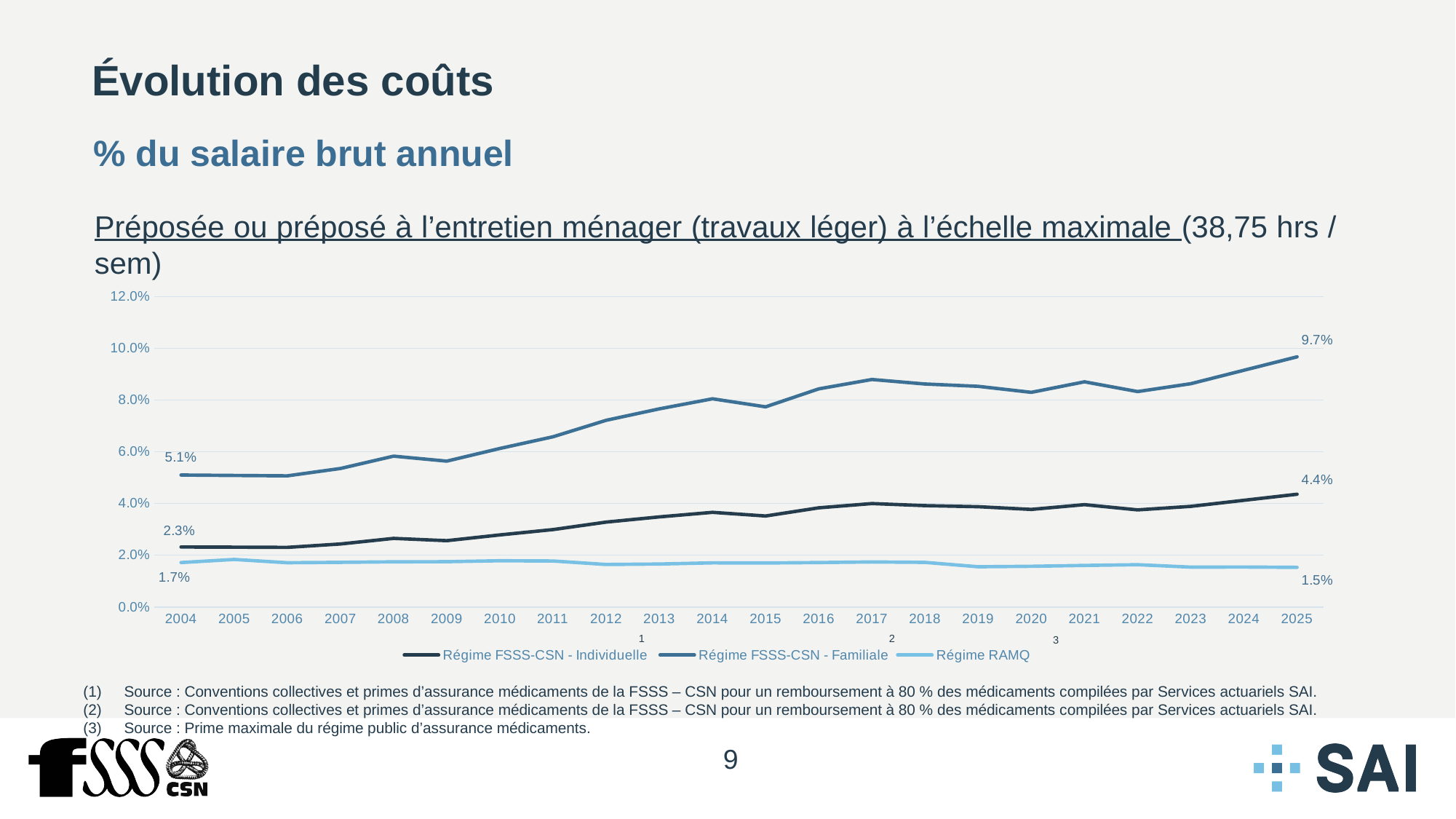
What is the value for Régime RAMQ in 2025? 1.5% What is the value for Régime FSSS-CSN - Individuelle in 2004? 2.3% What is the value for Régime FSSS-CSN - Familiale in 2004? 5.1% What is the value for Régime FSSS-CSN - Familiale in 2025? 9.7% Does the Régime FSSS-CSN - Individuelle series generally rise or fall from 2004 to 2025? rise What kind of chart is shown on the slide? line chart How many series does the legend list? 3 By how much did the Régime FSSS-CSN - Familiale value change from 2004 to 2025? 4.6% Is the value for Régime FSSS-CSN - Familiale in 2017 greater or less than 8.0%? greater Which series has the highest value in 2025? Régime FSSS-CSN - Familiale Which series has the lowest value in 2004? Régime RAMQ How many years are shown along the x axis? 22